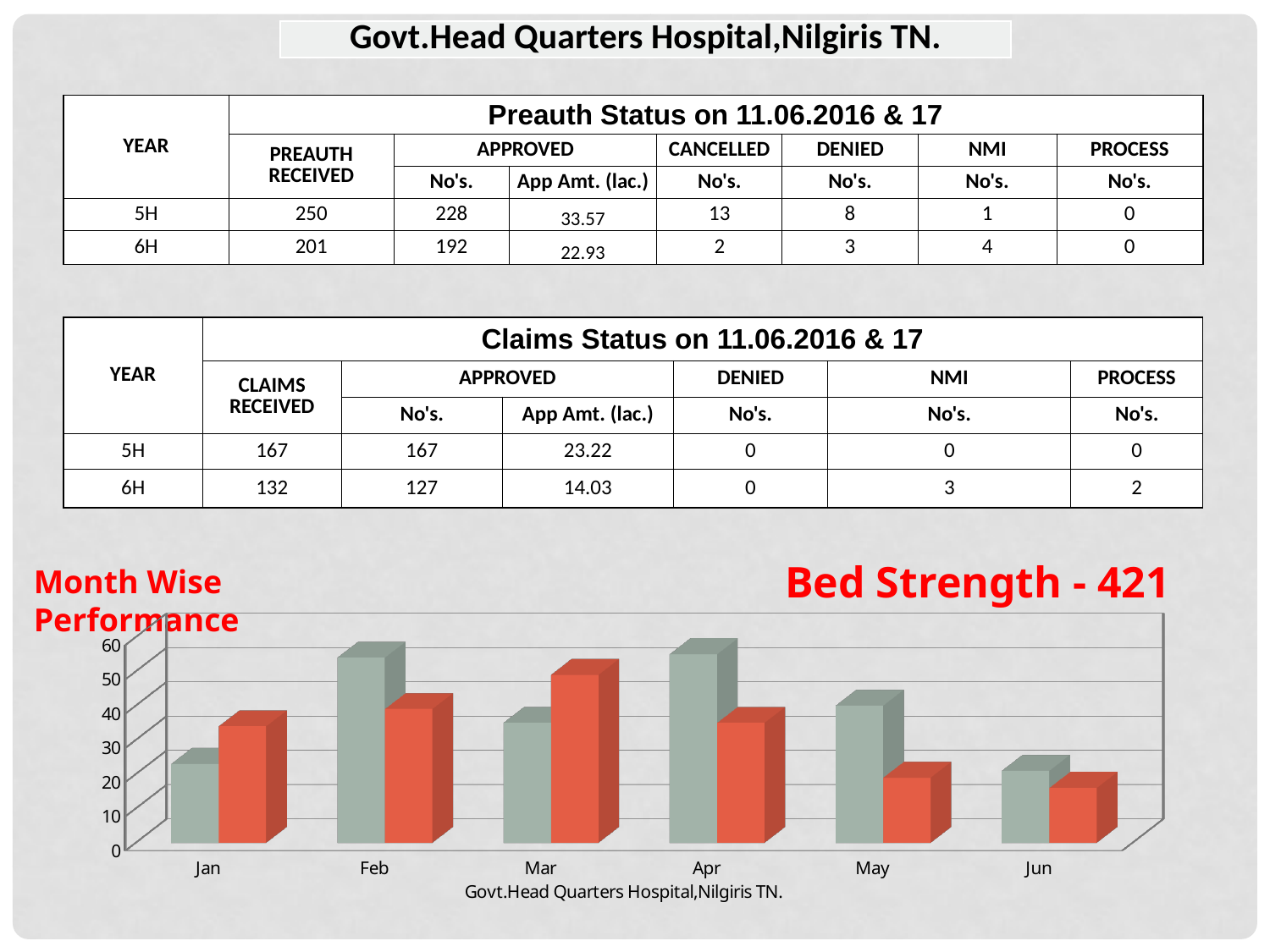
In the Month Wise Performance chart, is the grey bar for Jan greater or less than 30? less How many months are shown on the x axis of the Month Wise Performance chart? 6 In the Month Wise Performance chart, is the grey bar for Feb greater or less than 40? greater How many bars are plotted for each month in the Month Wise Performance chart? 2 In the Month Wise Performance chart, is the red bar for Mar greater or less than 40? greater What kind of chart is shown at the bottom of the slide? bar chart What text appears below the x axis of the Month Wise Performance chart? Govt.Head Quarters Hospital,Nilgiris TN. In the Month Wise Performance chart, for Jan, which bar is taller, the grey one or the red one? red In the Month Wise Performance chart, which month has the tallest red bar? Mar In the Month Wise Performance chart, for Feb, which bar is taller, the grey one or the red one? grey